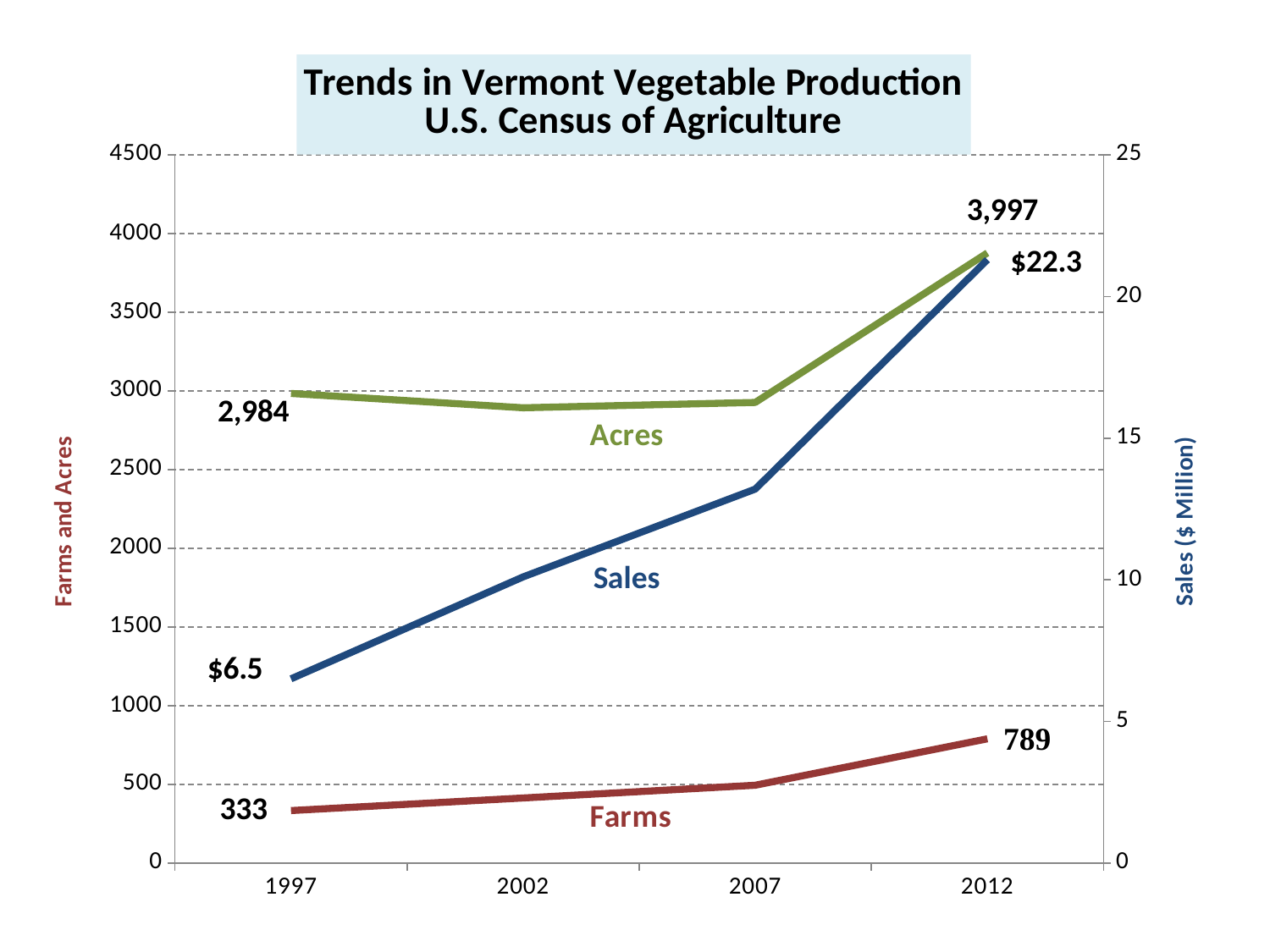
What is the Sales value in 1997? $6.5 What is the Sales value in 2012? $22.3 By how much did the number of Farms increase from 1997 to 2012? 456 What is the value for Acres in 2012? 3,997 How many years are plotted along the x axis? 4 What is the value for Acres in 1997? 2,984 What is the label of the right-hand vertical axis? Sales ($ Million) What kind of chart is shown on the slide? Line chart How many Farms are shown for 2012? 789 How many Farms are shown for 1997? 333 Is the Sales value for 2007 greater or less than 10 on the right-hand axis? greater What is the difference in Acres between 2012 and 1997? 1,013